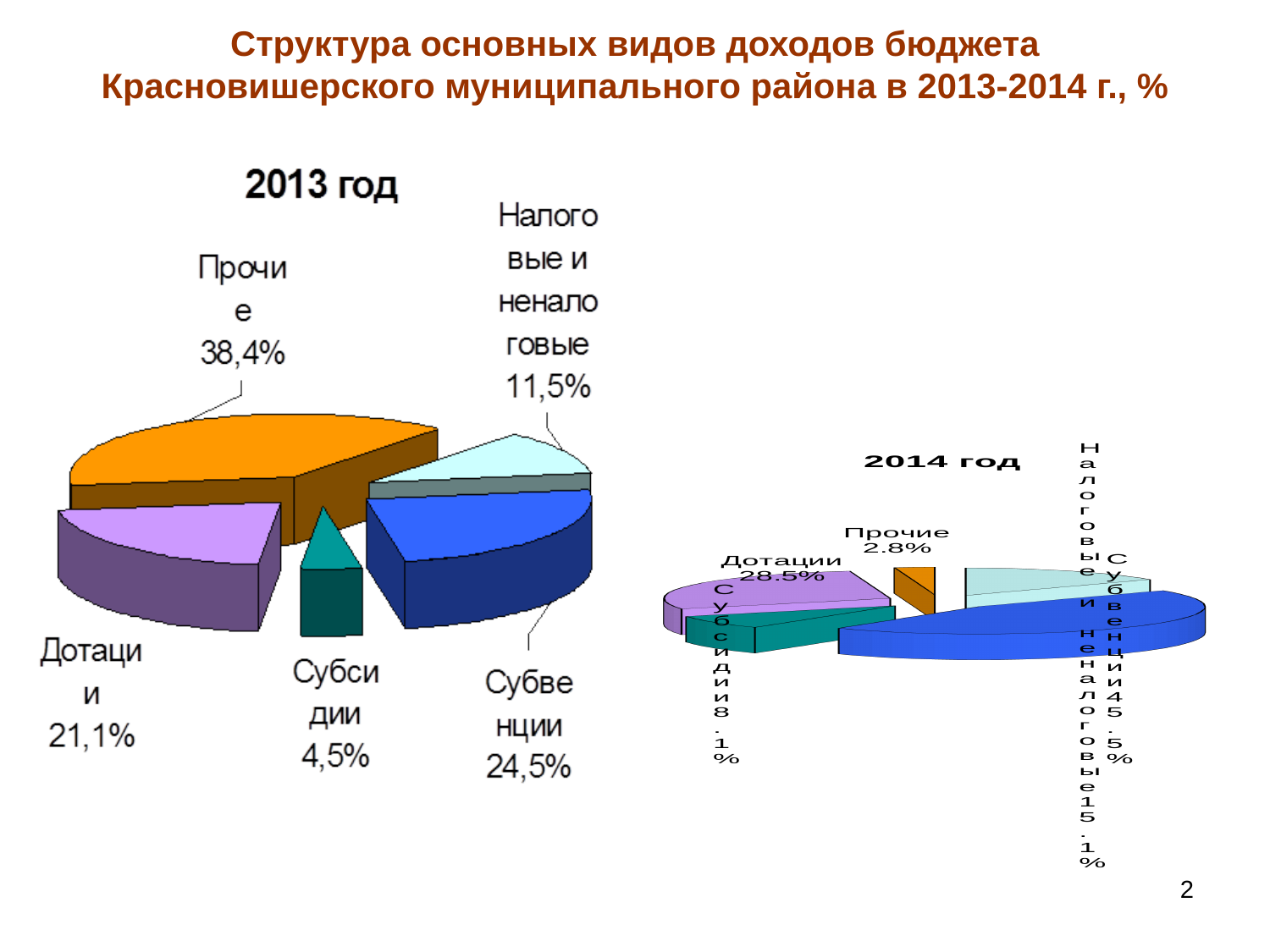
In the 2014 год chart, which is larger: Дотации or Налоговые и неналоговые? Дотации In the 2013 год chart, what share do Субвенции have? 24,5% In the 2014 год chart, which category has the largest share? Субвенции In the 2013 год chart, how many slices does the pie have? 5 In the 2014 год chart, what share do Прочие have? 2.8% In the 2014 год chart, what share do Дотации have? 28.5% In the 2013 год chart, what is the difference between the shares of Субвенции and Дотации? 3,4% What type of chart is used for the 2013 год data? Pie chart In the 2013 год chart, what share do Прочие have? 38,4% In the 2013 год chart, which category has the largest share? Прочие In the 2013 год chart, which category has the smallest share? Субсидии In the 2013 год chart, what share do Дотации have? 21,1%